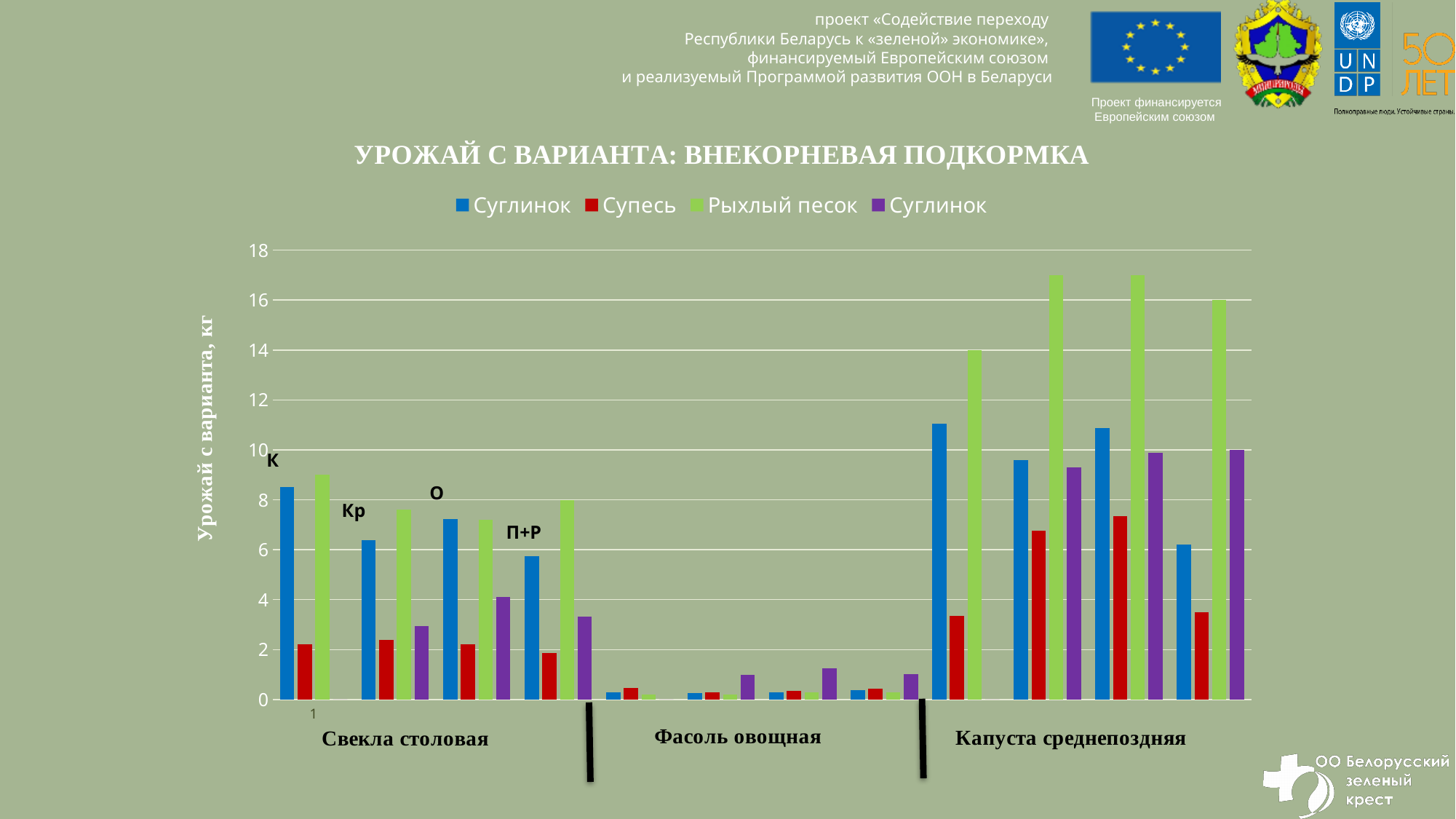
How many crop groups are labelled along the x axis? 3 Which crop group has the lowest yields overall? Фасоль овощная Are all the bars for Фасоль овощная greater or less than 2? less What is the title of the chart? УРОЖАЙ С ВАРИАНТА: ВНЕКОРНЕВАЯ ПОДКОРМКА How many series does the legend list? 4 Which crop group contains the highest bar on the chart? Капуста среднепоздняя What are the legend entries of the chart, in order? Суглинок, Супесь, Рыхлый песок, Суглинок For the К variant of Свекла столовая, which is larger: the blue Суглинок bar or the Супесь bar? the blue Суглинок bar Is the blue Суглинок bar for the К variant of Свекла столовая greater or less than 6? greater What kind of chart is shown on the slide? bar chart Is the tallest Рыхлый песок bar for Капуста среднепоздняя greater or less than 16? greater